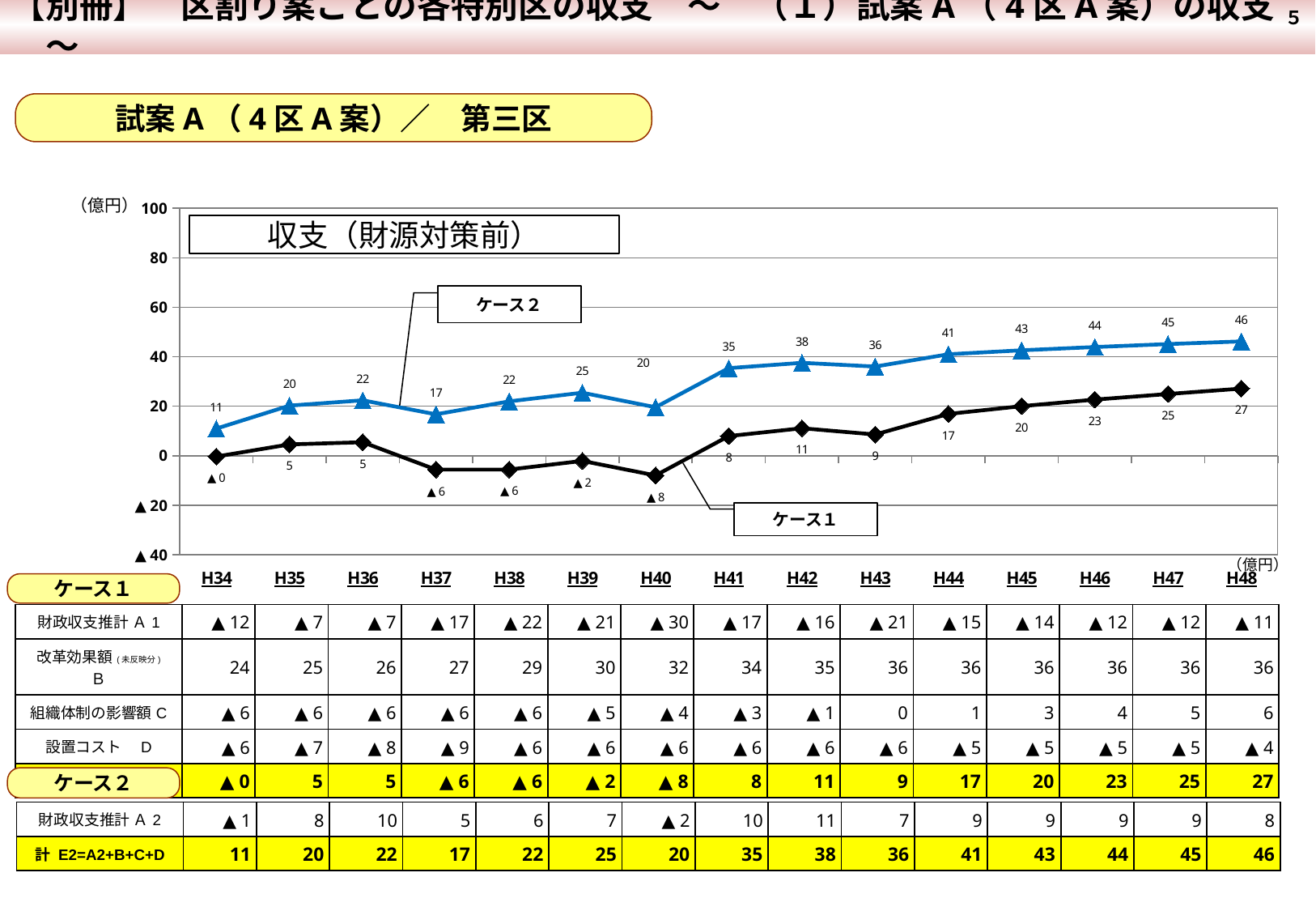
What is the value of ケース1 at H48? 27 What is the difference between ケース2 and ケース1 at H48? 19 Which is larger at H41, ケース1 or ケース2? ケース2 What kind of chart is shown? line chart What is the title of the chart? 収支（財源対策前） What is the value of ケース2 at H42? 38 At which year does ケース2 reach its highest value? H48 How many series are plotted in the chart? 2 What is the value of ケース1 at H40? ▲8 At which year is ケース1 at its lowest value? H40 How many years are plotted on the x axis? 15 What is the value of ケース2 at H34? 11